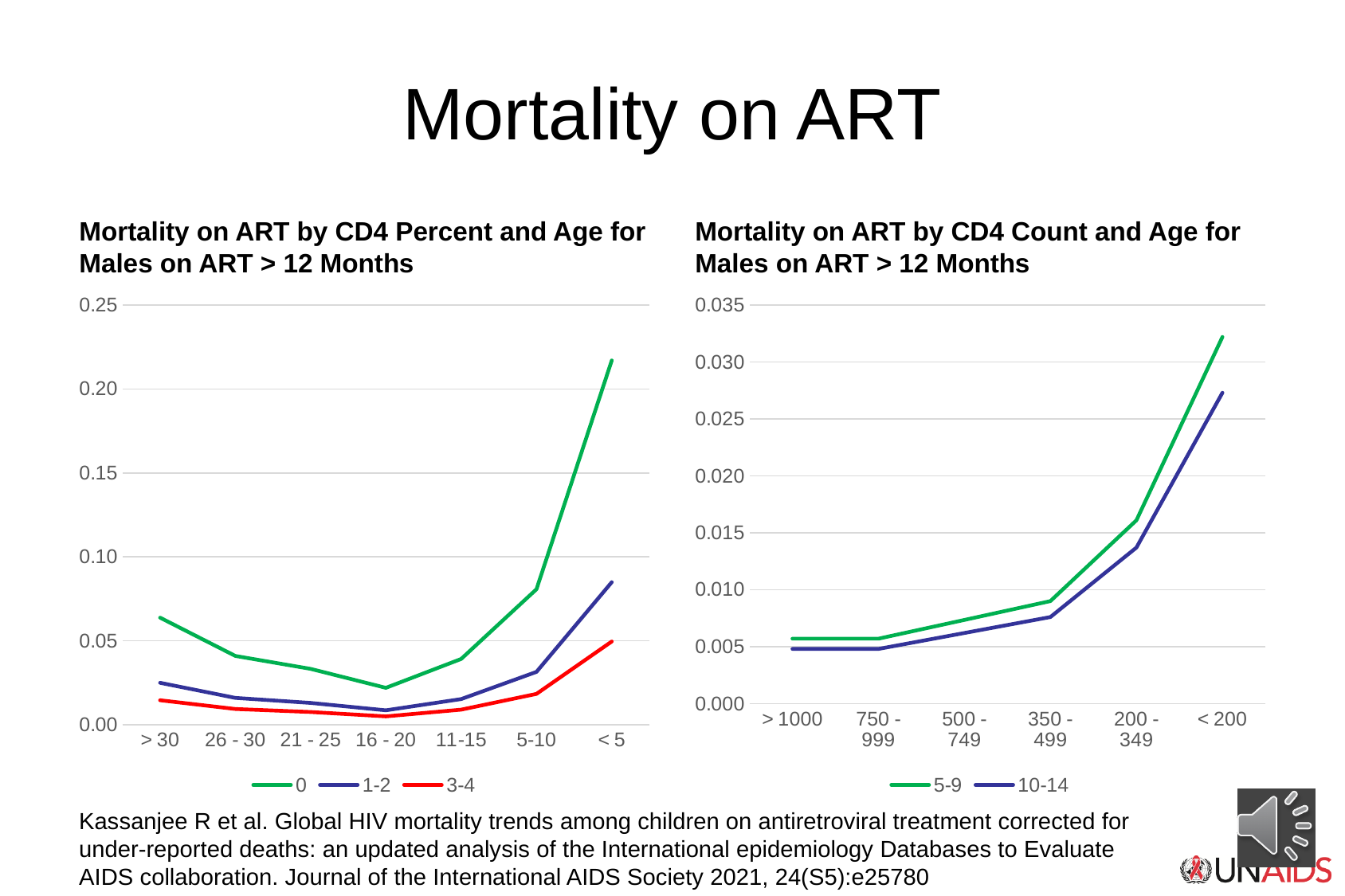
In the right chart (CD4 Count), at which CD4 count category is the value for the '10-14' series highest? < 200 In the left chart (CD4 Percent), is the value for the '1-2' series at '< 5' greater or less than 0.10? less In the left chart (CD4 Percent), at which CD4 percent category is the value for the '0' series highest? < 5 How many series does the legend of the right chart (CD4 Count) list? 2 In the left chart (CD4 Percent), is the value for the '0' series at '< 5' greater or less than 0.20? greater How many CD4 percent categories are shown on the x axis of the left chart? 7 In the left chart (CD4 Percent), which series has the higher value at '> 30': '0' or '3-4'? 0 How many series does the legend of the left chart (CD4 Percent) list? 3 In the right chart (CD4 Count), do the values for the '5-9' series rise or fall from '> 1000' to '< 200'? Rise What kind of chart is the left chart, 'Mortality on ART by CD4 Percent and Age for Males on ART > 12 Months'? Line chart In the right chart (CD4 Count), is the value for the '5-9' series at '< 200' greater or less than 0.030? greater How many CD4 count categories are shown on the x axis of the right chart? 6